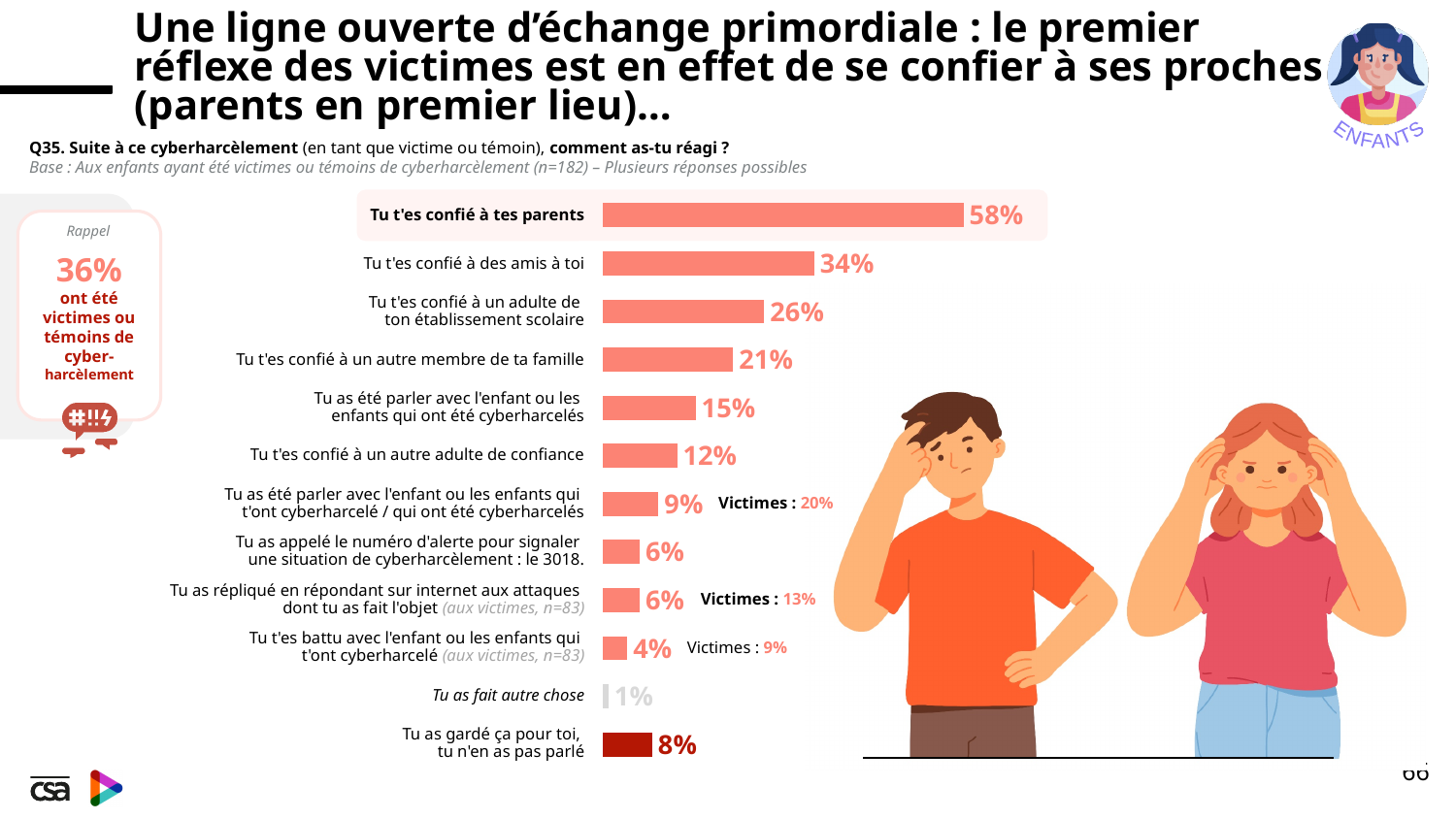
What kind of chart is shown on the slide? Bar chart What is the "Victimes" value shown next to "Tu as répliqué en répondant sur internet aux attaques dont tu as fait l'objet"? 13% Which response has the lowest percentage? Tu as fait autre chose What percentage of children said "Tu t'es confié à tes parents"? 58% What is the sample size (n) given in the base line under the question? n=182 What is the value for "Tu t'es confié à un autre adulte de confiance"? 12% Which is larger: "Tu t'es confié à un adulte de ton établissement scolaire" or "Tu t'es confié à un autre membre de ta famille"? Tu t'es confié à un adulte de ton établissement scolaire What is the difference in percentage points between "Tu t'es confié à tes parents" and "Tu t'es confié à des amis à toi"? 24 percentage points What is the value for "Tu t'es confié à des amis à toi"? 34% How many response categories are plotted in the chart? 12 Which response has the highest percentage? Tu t'es confié à tes parents What is the value for "Tu as gardé ça pour toi, tu n'en as pas parlé"? 8%